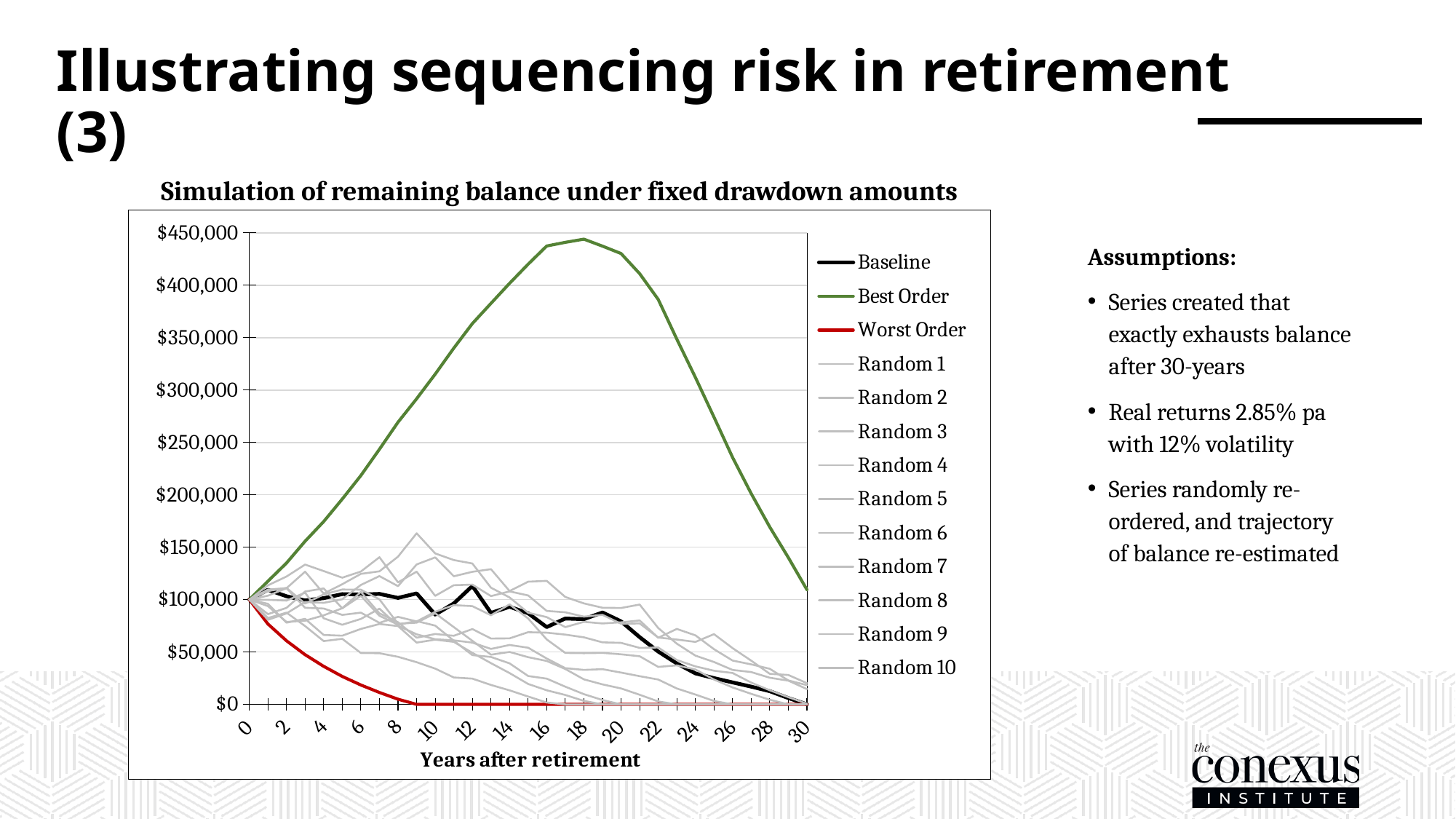
What is the value of the Worst Order series at year 20? $0 At year 10, which is larger: the Best Order value or the Baseline value? Best Order Is the value of the Best Order series at year 18 greater or less than $400,000? greater What is the title of the chart? Simulation of remaining balance under fixed drawdown amounts Which series reaches the highest balance on the chart? Best Order What colour is the Worst Order line in the chart? Red What is the starting value of the Baseline series at year 0? $100,000 Is the value of the Worst Order series at year 4 greater or less than $50,000? less How many series does the chart's legend list? 13 Does the Worst Order series rise or fall from year 0 to year 8? Fall Which series is the first to fall to $0? Worst Order What kind of chart is shown on the slide? Line chart